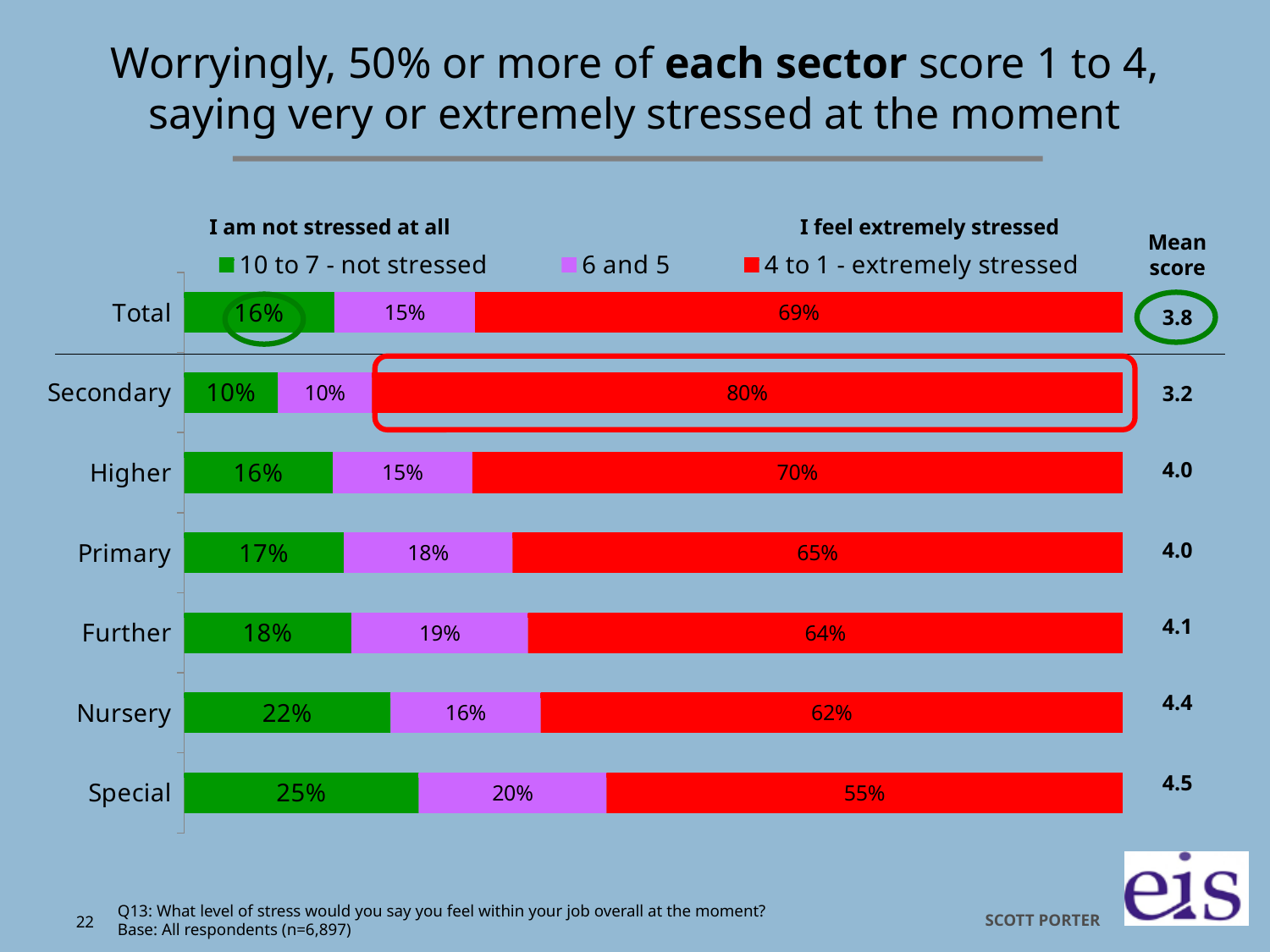
What percentage of Secondary respondents score 4 to 1 - extremely stressed? 80% How many categories (bars) are shown in the chart, including Total? 7 Which sector has the lowest percentage scoring 4 to 1 - extremely stressed? Special What is the mean score shown for the Nursery sector? 4.4 How many series does the legend list? 3 Which is larger: the percentage of Nursery respondents scoring 10 to 7 - not stressed, or the percentage of Further respondents scoring 10 to 7 - not stressed? Nursery What is the difference between the Secondary and Total percentages scoring 4 to 1 - extremely stressed? 11 percentage points What percentage of Special respondents score 10 to 7 - not stressed? 25% What percentage of Primary respondents score 6 and 5? 18% What kind of chart is shown on the slide? Stacked bar chart What colour represents the '4 to 1 - extremely stressed' series? Red Which sector has the highest percentage scoring 4 to 1 - extremely stressed? Secondary